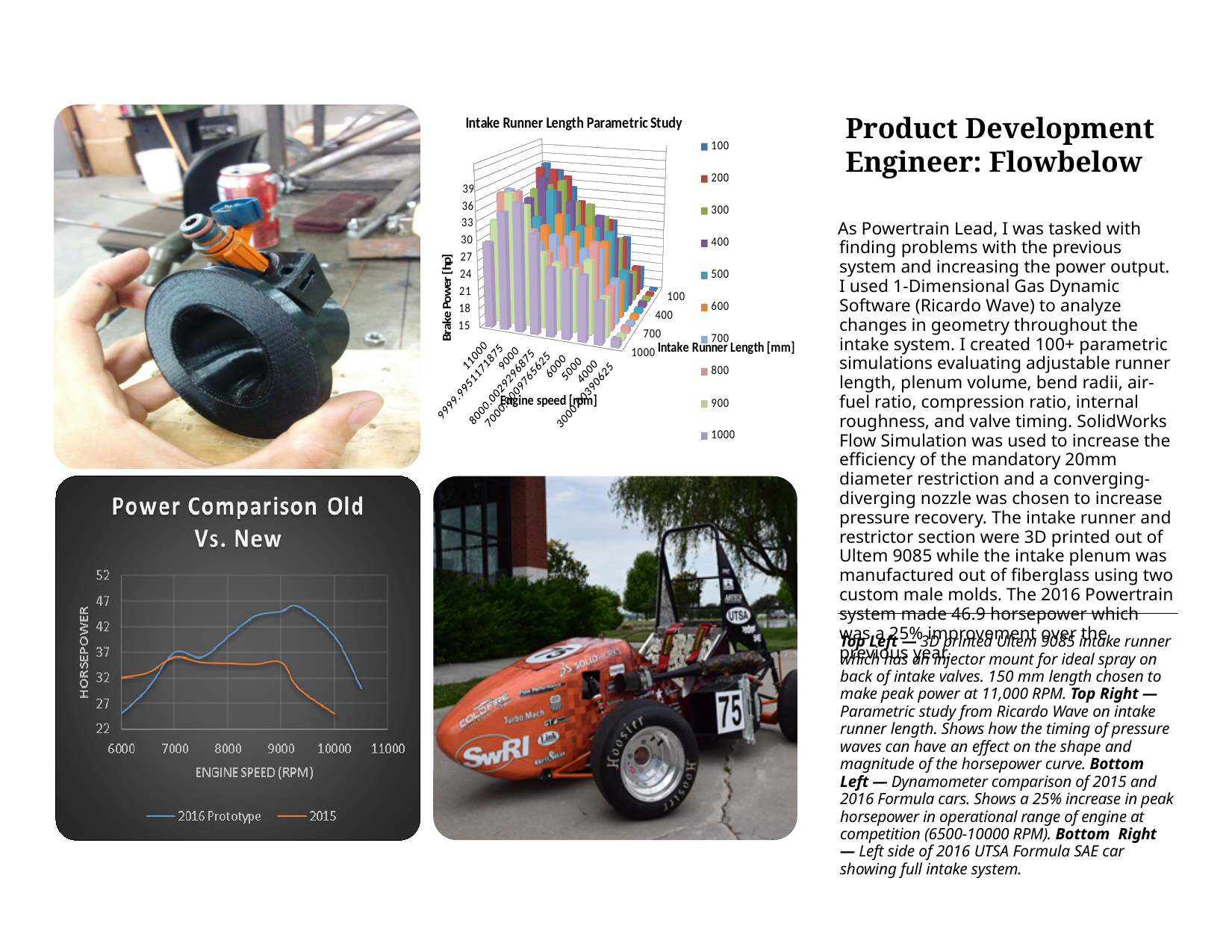
What kind of chart is the 'Power Comparison Old Vs. New' chart? line chart In the 'Power Comparison Old Vs. New' chart, which series has the higher value at 8000 RPM, 2016 Prototype or 2015? 2016 Prototype How many series does the legend of the 'Intake Runner Length Parametric Study' chart list? 10 What kind of chart is the 'Intake Runner Length Parametric Study' chart? bar chart What is the title of the chart in the bottom-left of the slide? Power Comparison Old Vs. New In the 'Power Comparison Old Vs. New' chart, does the 2016 Prototype line rise or fall between 6000 and 9000 RPM? rise What is the vertical axis label of the 'Intake Runner Length Parametric Study' chart? Brake Power [hp] How many series does the legend of the 'Power Comparison Old Vs. New' chart list? 2 In the 'Power Comparison Old Vs. New' chart, does the 2015 line rise or fall between 9000 and 10000 RPM? fall In the 'Power Comparison Old Vs. New' chart, is the 2016 Prototype value at 9000 RPM greater or less than 42? greater In the 'Power Comparison Old Vs. New' chart, which series has the higher value at 6000 RPM, 2016 Prototype or 2015? 2015 In the 'Power Comparison Old Vs. New' chart, is the 2015 value at 9000 RPM greater or less than 37? less